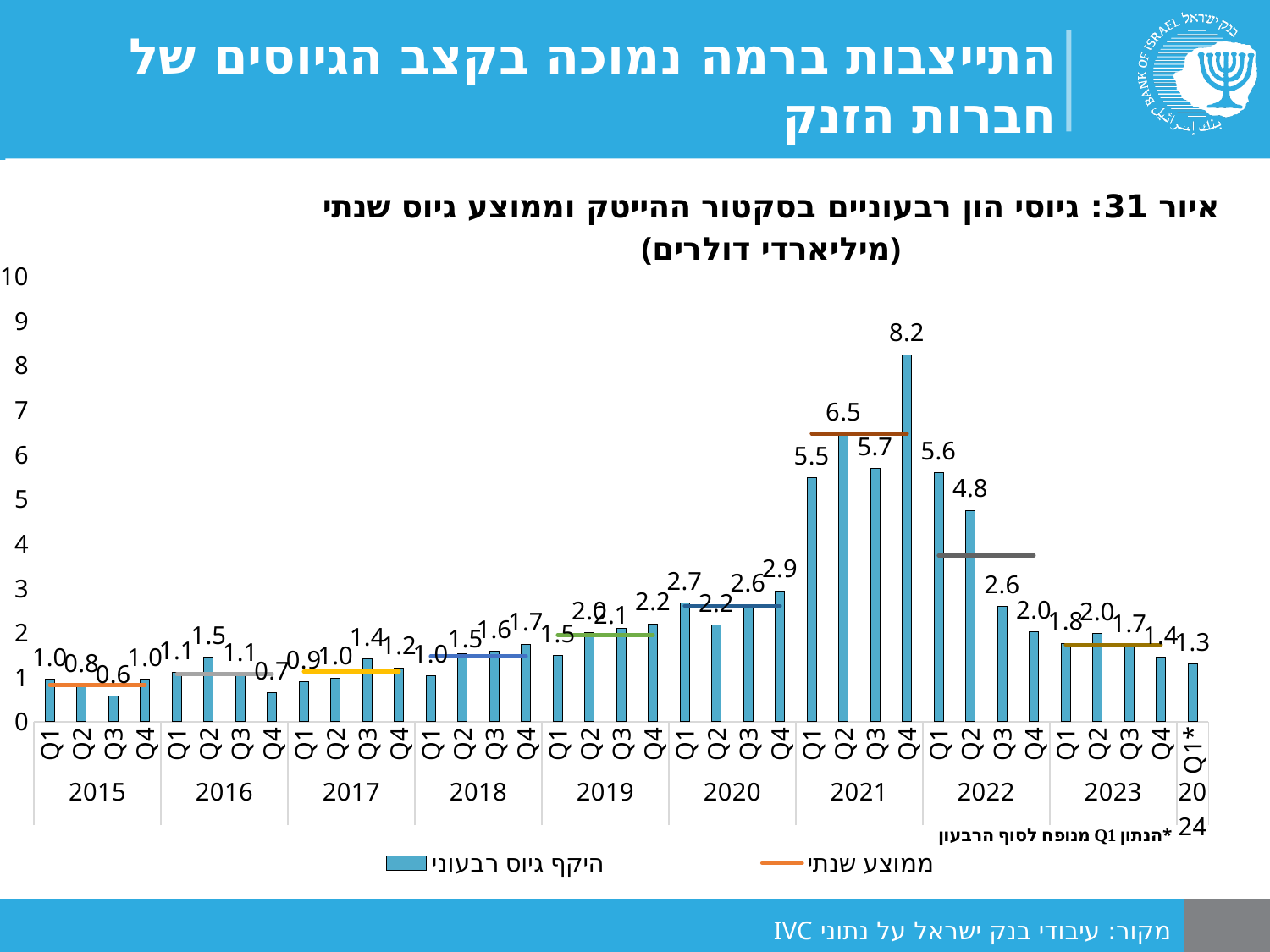
What is the value for Q4 2020? 2.9 Do the quarterly values rise or fall from Q1 2022 to Q4 2022? fall What is the value for Q3 2015? 0.6 How many series does the legend list? 2 What is the value for Q1* 2024? 1.3 Is the value for Q1 2021 greater or less than 5? greater What kind of chart is this? combination bar and line chart What is the value for Q4 2021? 8.2 What is the value for Q2 2021? 6.5 Which is larger, the value for Q2 2022 or the value for Q3 2022? Q2 2022 What is the difference between the values for Q4 2021 and Q1 2022? 2.6 Which quarter has the highest value? Q4 2021